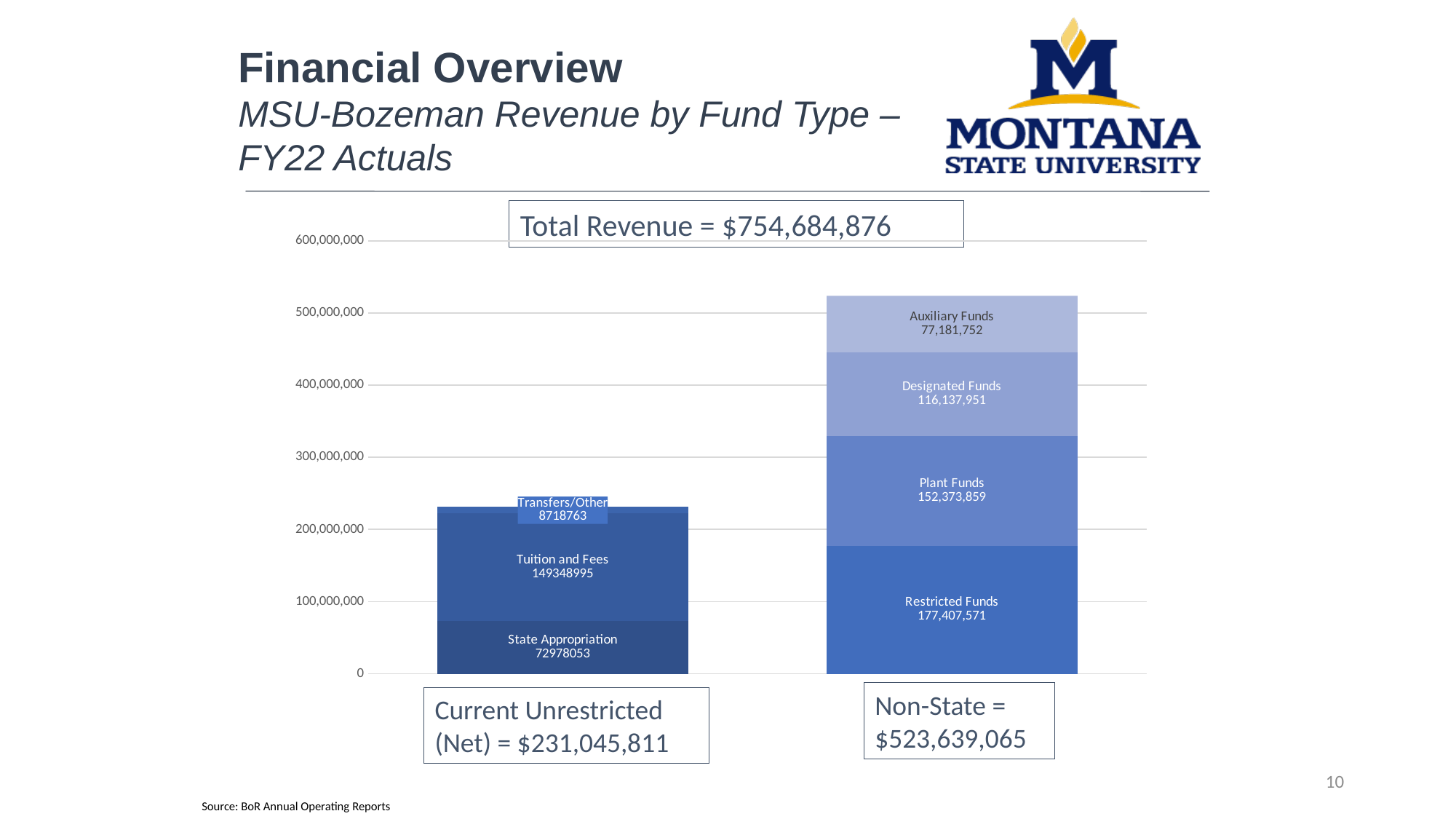
What is the total of the Non-State stacked bar? $523,639,065 Which segment across both bars has the largest value? Restricted Funds What is the value of the Auxiliary Funds segment? 77,181,752 What is the value of the Tuition and Fees segment in the Current Unrestricted bar? 149348995 Is the total of the Current Unrestricted (Net) bar greater or less than 300,000,000? less What is the difference between the Restricted Funds and Plant Funds segments? 25,033,712 What is the difference between the Tuition and Fees and State Appropriation segments? 76,370,942 What is the value of the Transfers/Other segment? 8718763 What is the value of the Restricted Funds segment in the Non-State bar? 177,407,571 Which is larger, the Designated Funds segment or the Plant Funds segment? Plant Funds What type of chart is shown on the slide? Stacked bar chart